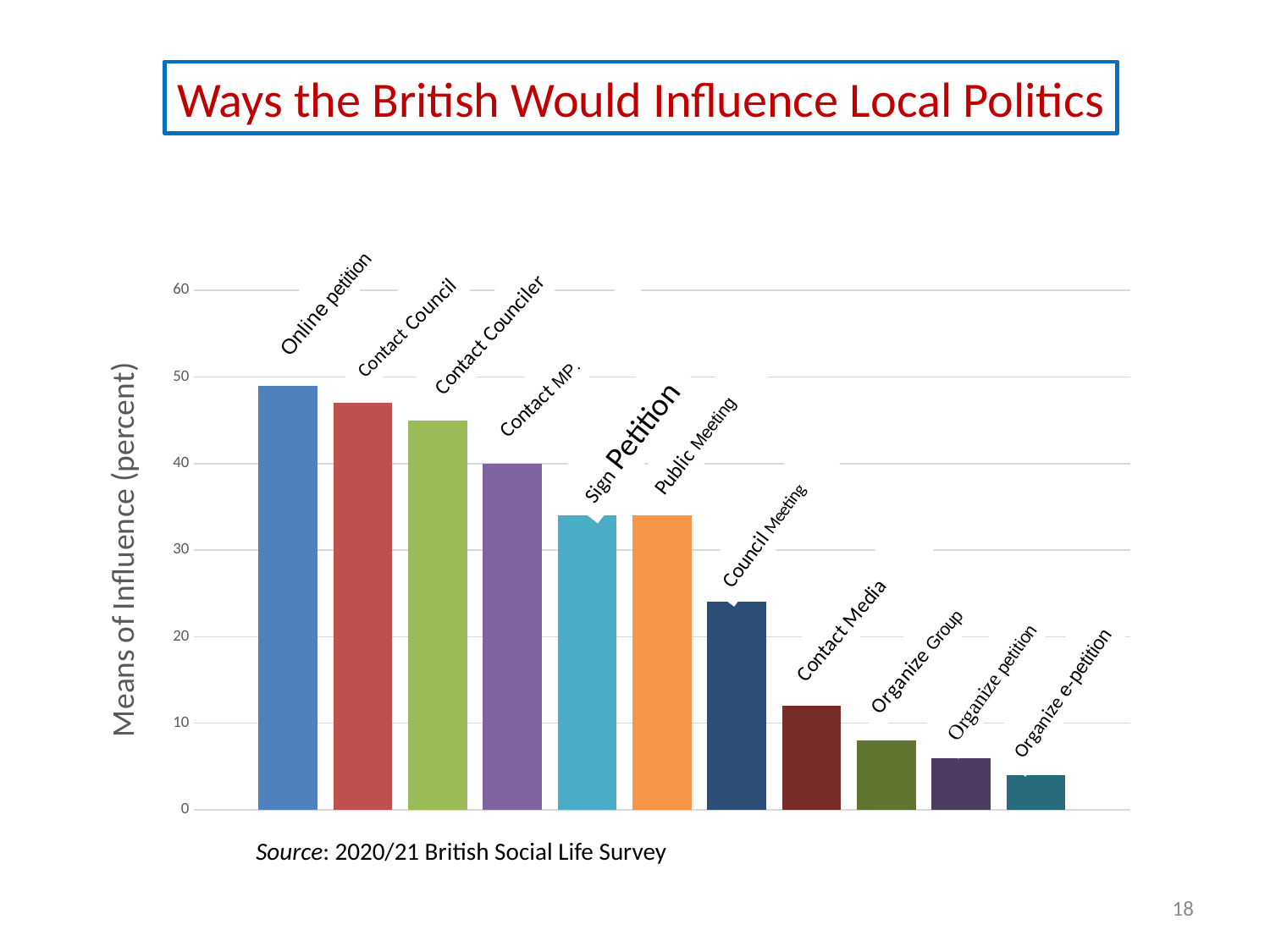
Is the value for Contact Media greater or less than 10? greater Which is larger, the value for Contact Council or the value for Public Meeting? Contact Council Do the values rise or fall moving from left to right along the x axis? fall What is the label on the vertical axis? Means of Influence (percent) What kind of chart is shown on the slide? bar chart Is the value for Council Meeting greater or less than 30? less What is the value for Contact MP? 40 Which means of influence has the lowest value? Organize e-petition What is the title of the chart? Ways the British Would Influence Local Politics How many categories (means of influence) are plotted in the chart? 11 Is the value for Online petition greater or less than 40? greater Which means of influence has the highest value? Online petition